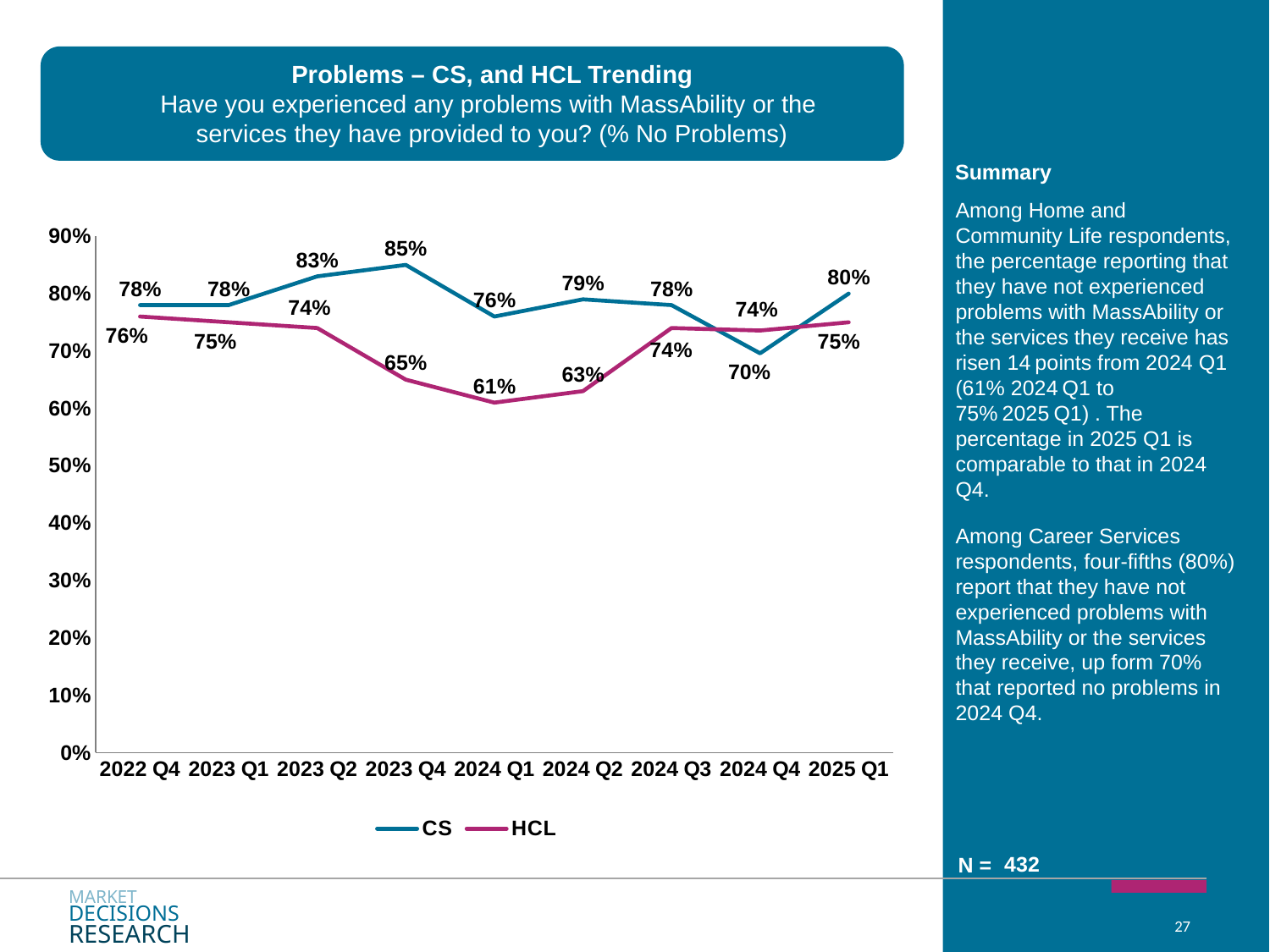
Which series has the higher value in 2024 Q4, CS or HCL? HCL How many series does the legend list? 2 What is the CS value for 2025 Q1? 80% What is the difference between the CS and HCL values in 2023 Q4? 20 percentage points In which quarter is the CS value lowest? 2024 Q4 How many quarters are shown on the x axis? 9 Does the HCL value rise or fall from 2024 Q1 to 2025 Q1? Rise In which quarter is the CS value highest? 2023 Q4 What kind of chart is shown on the slide? Line chart In which quarter is the HCL value lowest? 2024 Q1 What is the HCL value for 2024 Q1? 61% What is the CS value for 2023 Q4? 85%